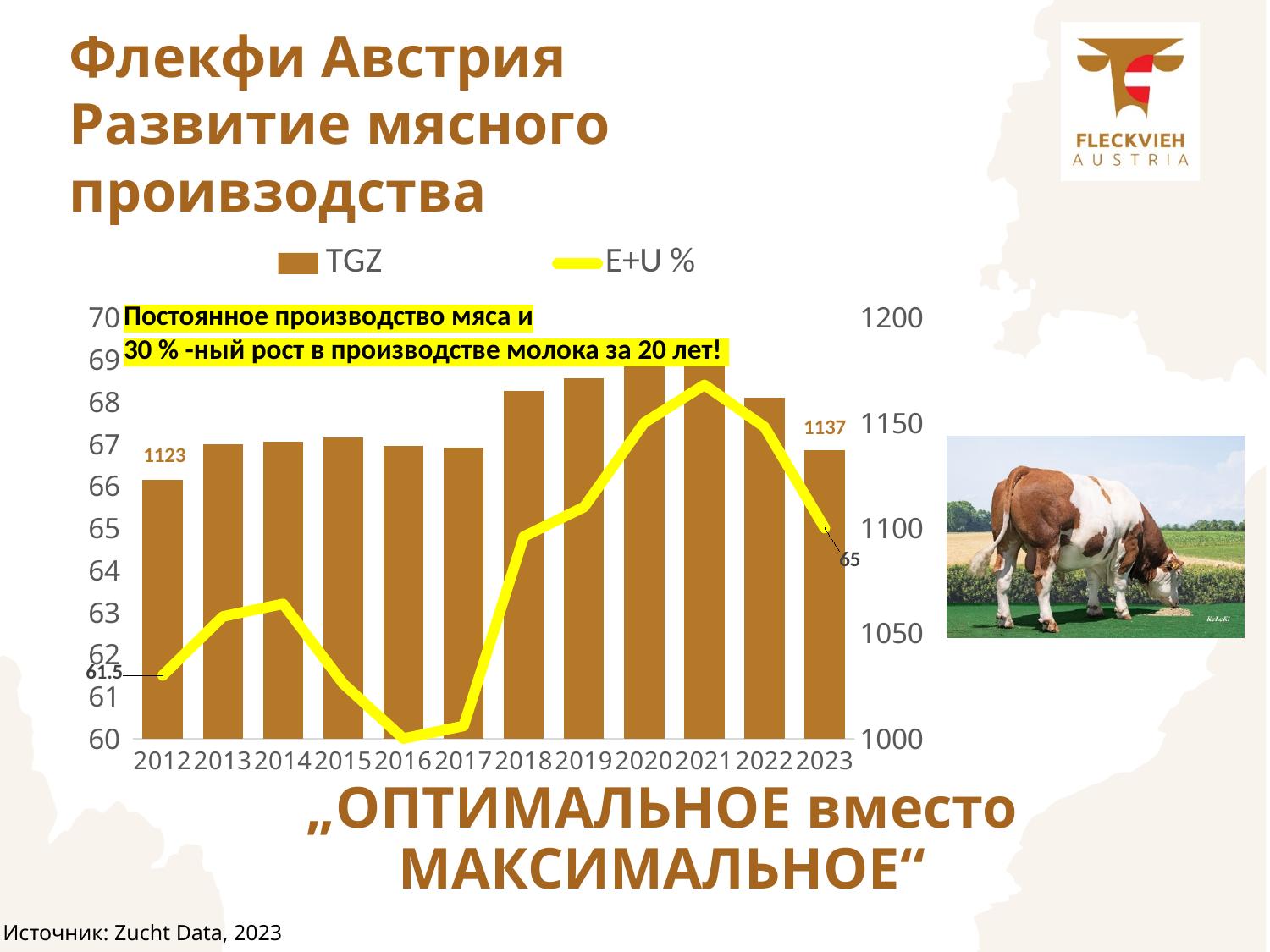
What is the E+U % value for 2012? 61.5 What is the TGZ value for 2023? 1137 Is the TGZ value for 2018 greater or less than 1150? greater What is the E+U % value for 2023? 65 How many series does the legend list? 2 What is the TGZ value for 2012? 1123 Which year has the lowest TGZ bar? 2012 In which year does the E+U % line reach its lowest point? 2016 By how much does the TGZ value for 2023 exceed the TGZ value for 2012? 14 In which year does the E+U % line reach its highest point? 2021 How many years are shown on the x axis? 12 What is the difference between the E+U % values for 2023 and 2012? 3.5